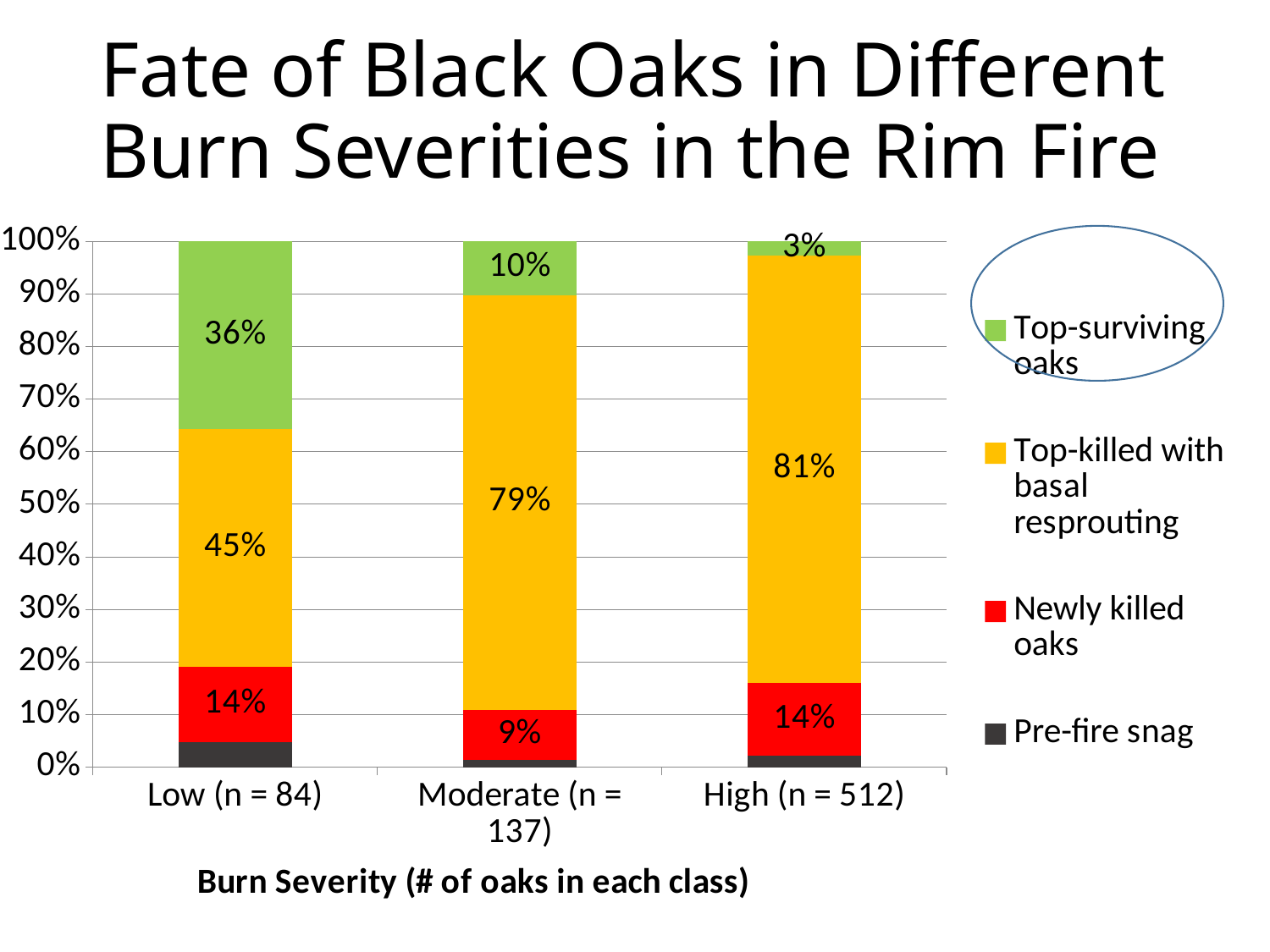
Which burn severity class has the lowest percentage of top-killed with basal resprouting? Low (n = 84) What percentage of black oaks in the Low burn severity class were top-surviving oaks? 36% How many series does the legend list? 4 Does the share of top-surviving oaks rise or fall as burn severity goes from Low to High? Fall What kind of chart is shown on the slide? Stacked bar chart Which is larger: the newly killed oaks share in the Low class or in the Moderate class? Low class What percentage of black oaks in the Moderate burn severity class were newly killed oaks? 9% How many burn severity classes are shown on the x axis? 3 Which burn severity class has the highest percentage of top-surviving oaks? Low (n = 84) What percentage of black oaks in the High (n = 512) class were top-killed with basal resprouting? 81% Is the Pre-fire snag share for the Low (n = 84) class greater or less than 10%? less How many percentage points higher is the top-surviving oaks share in the Low class than in the Moderate class? 26 percentage points